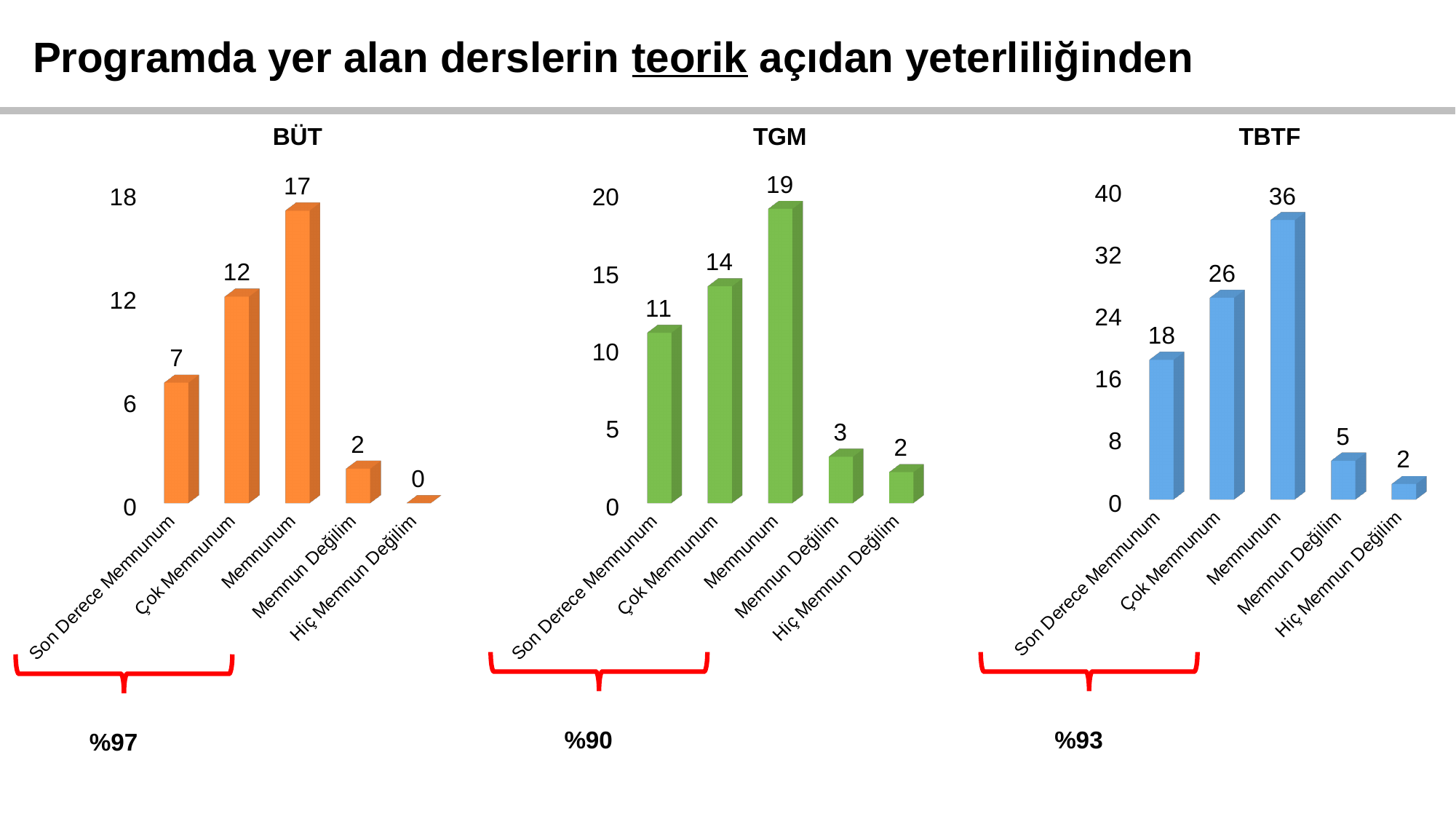
How many categories does the TGM chart show? 5 What colour are the bars in the TBTF chart? Blue In the TGM chart, what is the value for Çok Memnunum? 14 In the TBTF chart, which category has the highest value? Memnunum In the TBTF chart, which is larger: Çok Memnunum or Son Derece Memnunum? Çok Memnunum In the TBTF chart, what is the value for Son Derece Memnunum? 18 In the TGM chart, what is the value for Memnun Değilim? 3 In the BÜT chart, what is the total of Son Derece Memnunum, Çok Memnunum and Memnunum? 36 In the BÜT chart, which category has the lowest value? Hiç Memnun Değilim In the TGM chart, what is the difference between Memnunum and Son Derece Memnunum? 8 In the BÜT chart, what is the value for Memnunum? 17 What kind of chart is the BÜT chart? Bar chart